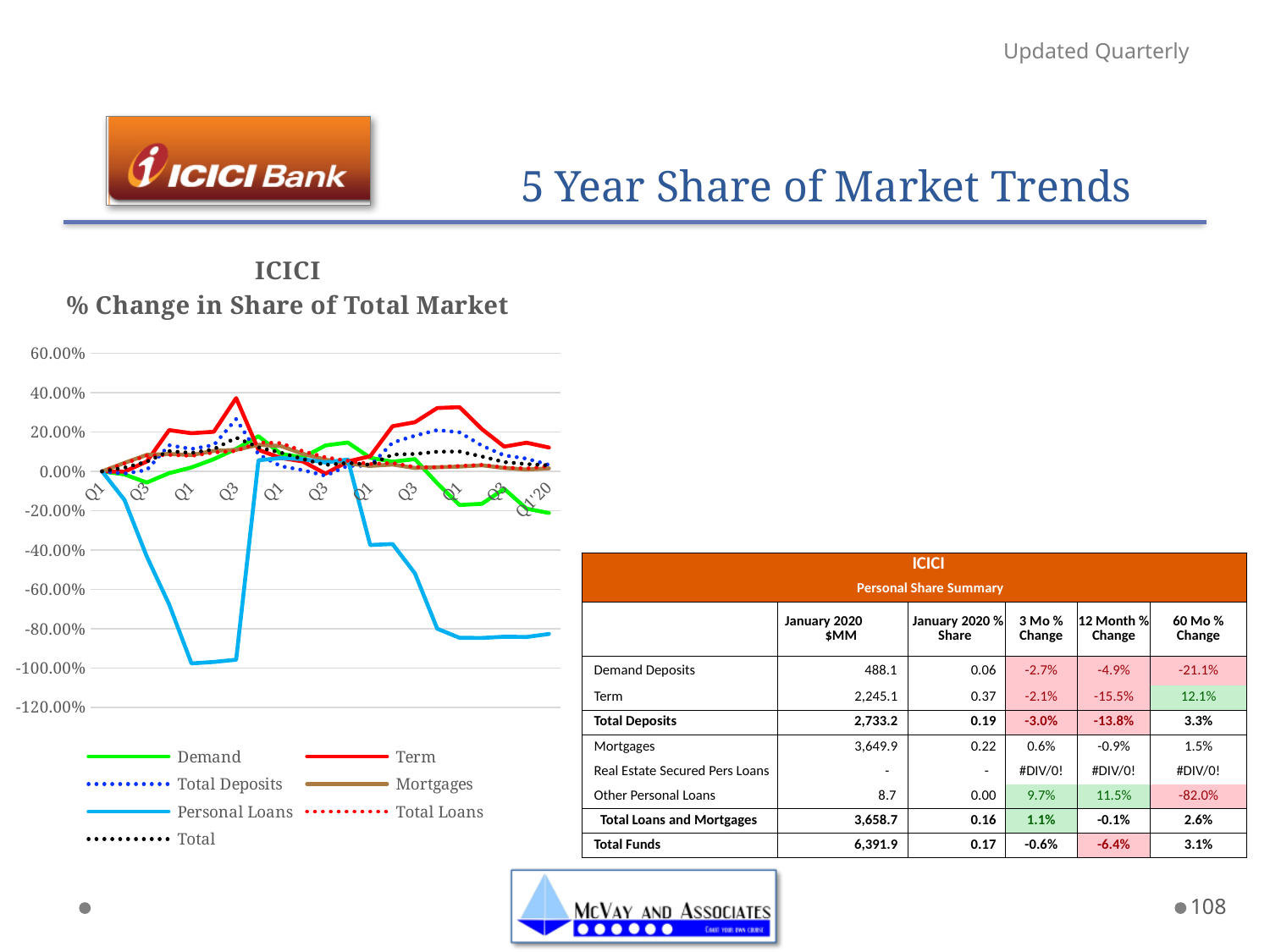
Which series reaches the lowest value on the chart? Personal Loans What colour is the Term line in the chart? red Is the value for Term at Q1'20 greater or less than 0.00%? greater Which series reaches the highest value on the chart? Term Is the highest value of the Term series greater or less than 20.00%? greater Is the value for Personal Loans at Q1'20 greater or less than -60.00%? less How many series does the chart legend list? 7 What kind of chart is shown on the slide? line chart Does the Personal Loans series overall rise or fall from the first quarter to Q1'20? fall What is the title of the chart? ICICI % Change in Share of Total Market At Q1'20, which is higher: Term or Demand? Term